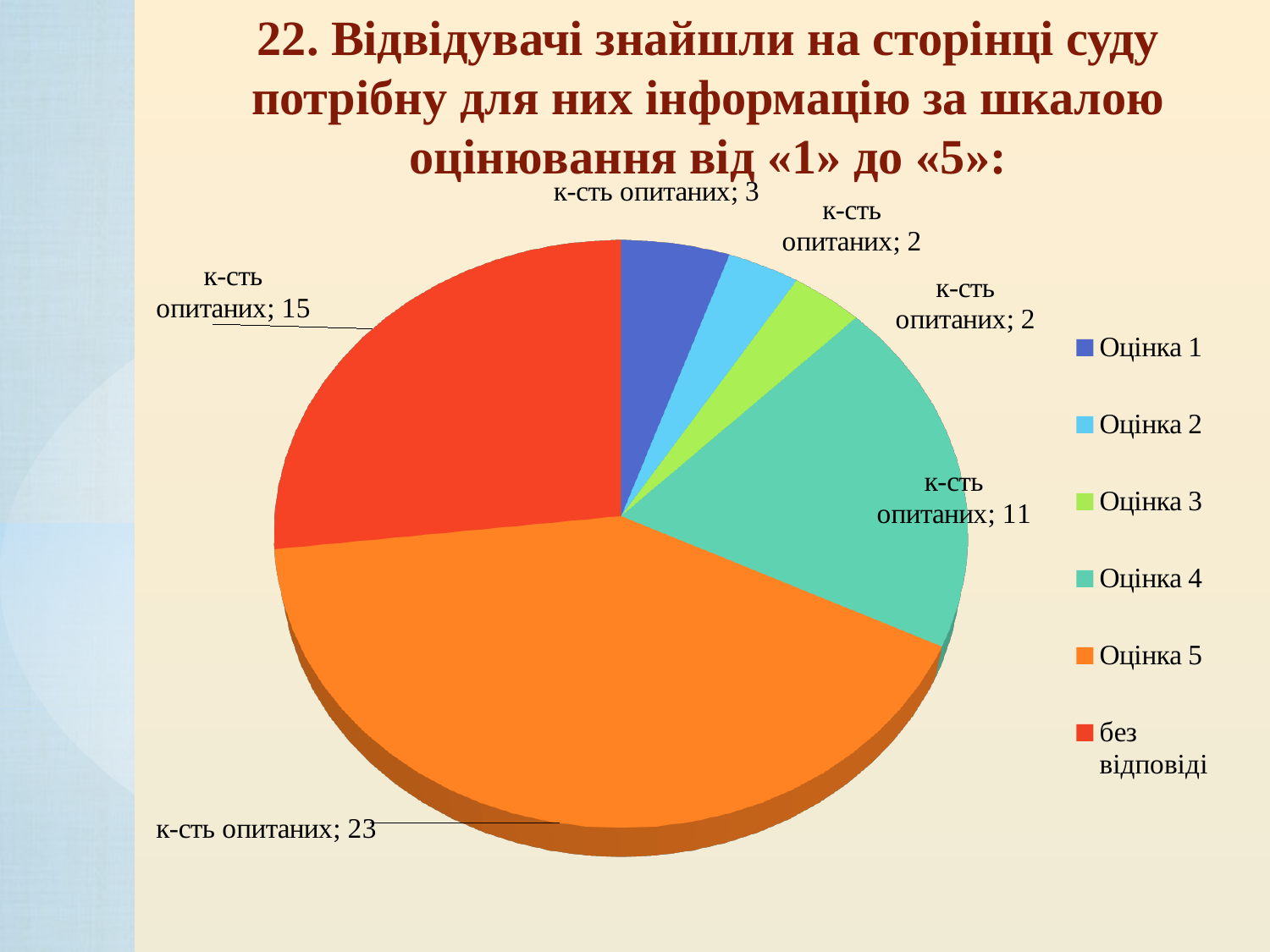
What is the difference between the number of respondents for Оцінка 5 and for Оцінка 4? 12 What is the difference between the number of respondents for 'без відповіді' and for Оцінка 1? 12 How many categories does the legend list? 6 What is the total number of respondents across all slices of the pie? 56 What colour is the slice for Оцінка 4? teal (green-blue) What kind of chart is shown on the slide? pie chart How many respondents are in the 'без відповіді' category? 15 How many respondents gave Оцінка 1? 3 How many respondents gave Оцінка 4? 11 How many respondents gave Оцінка 5? 23 Which is larger: the number of respondents for Оцінка 4 or for 'без відповіді'? без відповіді Which category has the largest slice of the pie? Оцінка 5